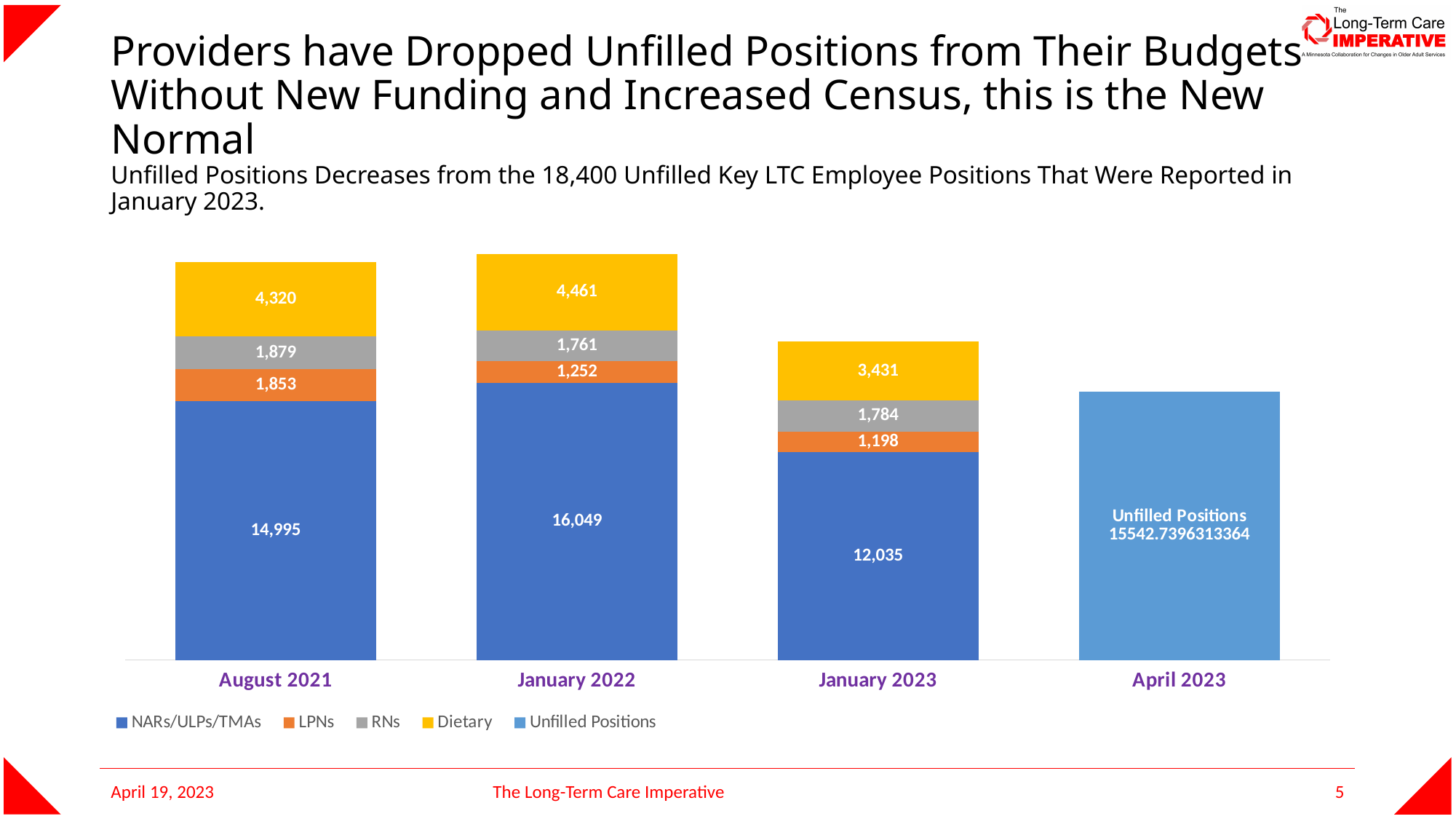
What is the RNs value for January 2023? 1,784 How many series does the legend list? 5 What is the Dietary value for January 2023? 3,431 What is the value for NARs/ULPs/TMAs in January 2022? 16,049 What type of chart is shown on the slide? Stacked bar chart How many time periods are shown on the x axis? 4 What is the difference between the Dietary values for January 2022 and January 2023? 1,030 Which period has the highest NARs/ULPs/TMAs value? January 2022 Is the NARs/ULPs/TMAs value larger in August 2021 or January 2023? August 2021 What is the LPNs value for August 2021? 1,853 What is the total of the stacked bar for January 2023? 18,448 Which period has the lowest LPNs value? January 2023